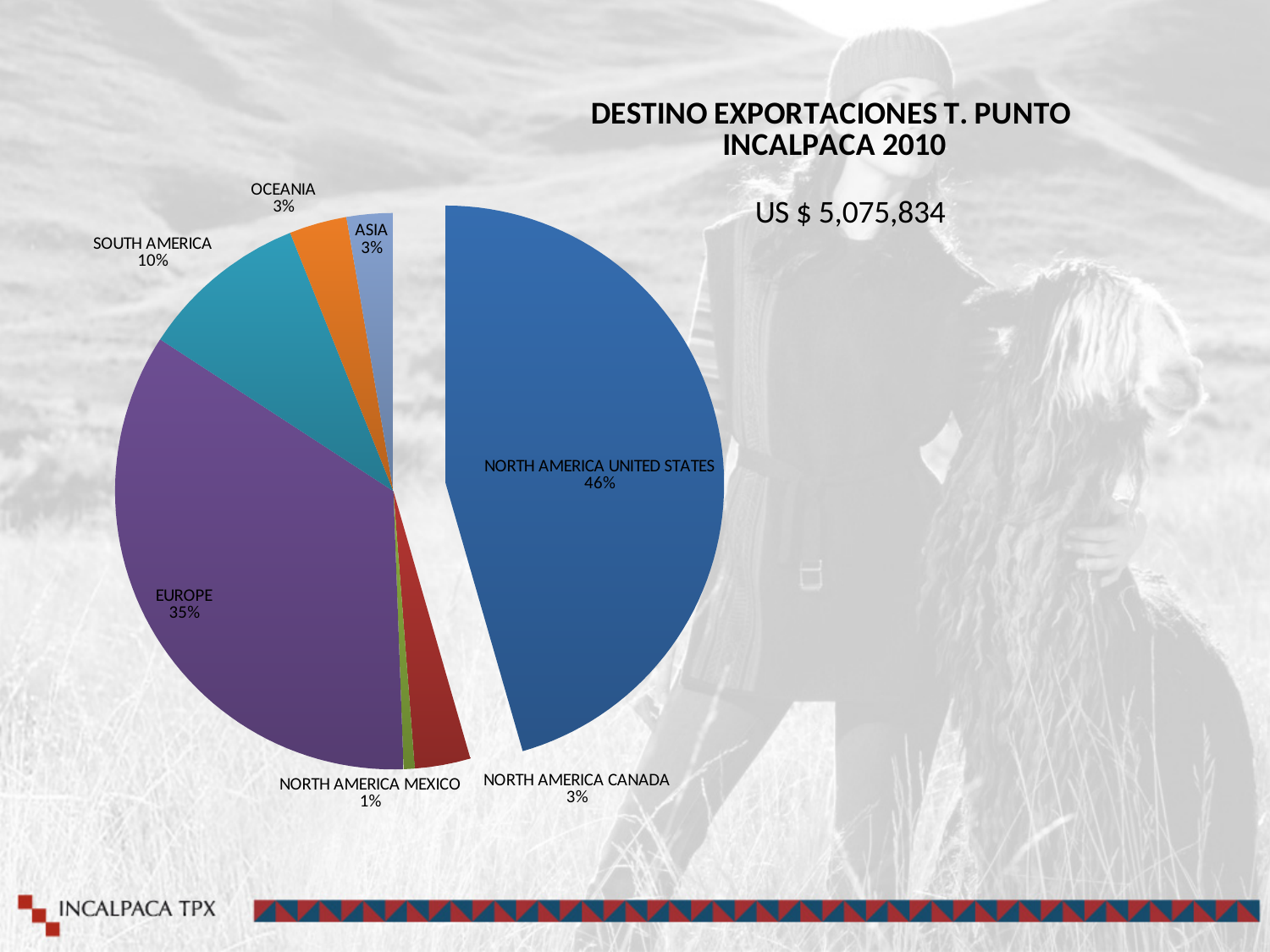
What share of exports went to Europe? 35% What share of exports went to South America? 10% What type of chart is shown on the slide? Pie chart Which destination has the smallest share of exports? North America Mexico What share of exports went to North America Mexico? 1% What is the title of the chart? DESTINO EXPORTACIONES T. PUNTO INCALPACA 2010 Which destination has the largest share of exports? North America United States What total export value is stated on the slide? US $ 5,075,834 Which has a larger share, South America or Oceania? South America How many destination slices does the pie chart show? 7 What share of exports went to North America United States? 46% What is the difference in share between North America United States and Europe? 11 percentage points